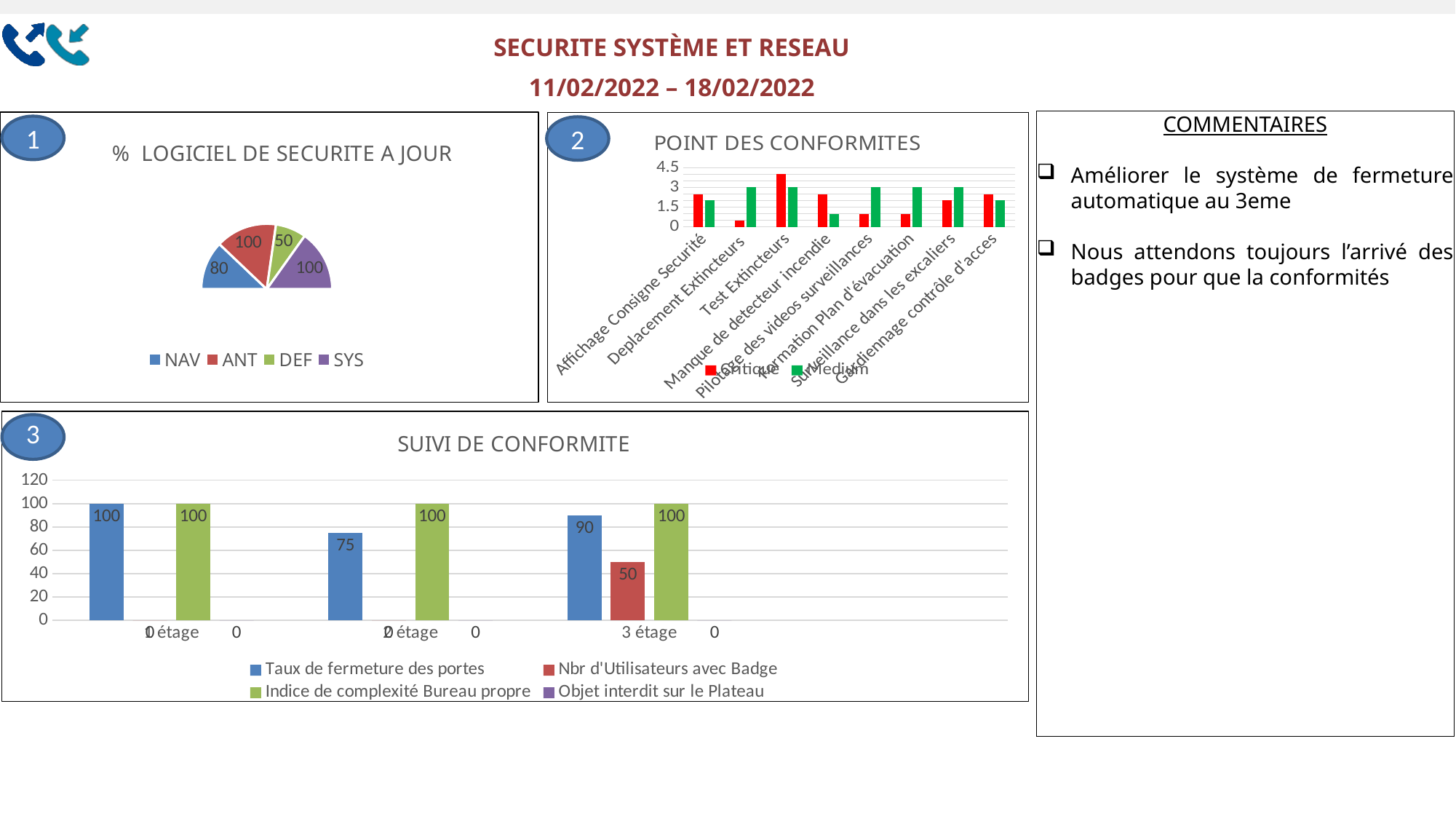
In the 'POINT DES CONFORMITES' chart, which category has the highest Critique value? Test Extincteurs How many entries does the legend of the '% LOGICIEL DE SECURITE A JOUR' chart list? 4 What kind of chart is 'SUIVI DE CONFORMITE'? Bar chart In the 'POINT DES CONFORMITES' chart, is the Critique value for Test Extincteurs greater or less than 3? greater In the 'SUIVI DE CONFORMITE' chart, what is the value of 'Nbr d'Utilisateurs avec Badge' for 3 étage? 50 In the '% LOGICIEL DE SECURITE A JOUR' chart, which category has the lowest value? DEF In the 'POINT DES CONFORMITES' chart, how many categories are shown on the x axis? 8 In the 'SUIVI DE CONFORMITE' chart, what is the value of 'Taux de fermeture des portes' for 2 étage? 75 In the '% LOGICIEL DE SECURITE A JOUR' chart, what is the value for NAV? 80 In the 'SUIVI DE CONFORMITE' chart, which is larger: 'Taux de fermeture des portes' for 2 étage or for 3 étage? 3 étage In the 'POINT DES CONFORMITES' chart, what are the two series listed in the legend? Critique and Medium In the '% LOGICIEL DE SECURITE A JOUR' chart, what is the difference between the values for ANT and DEF? 50